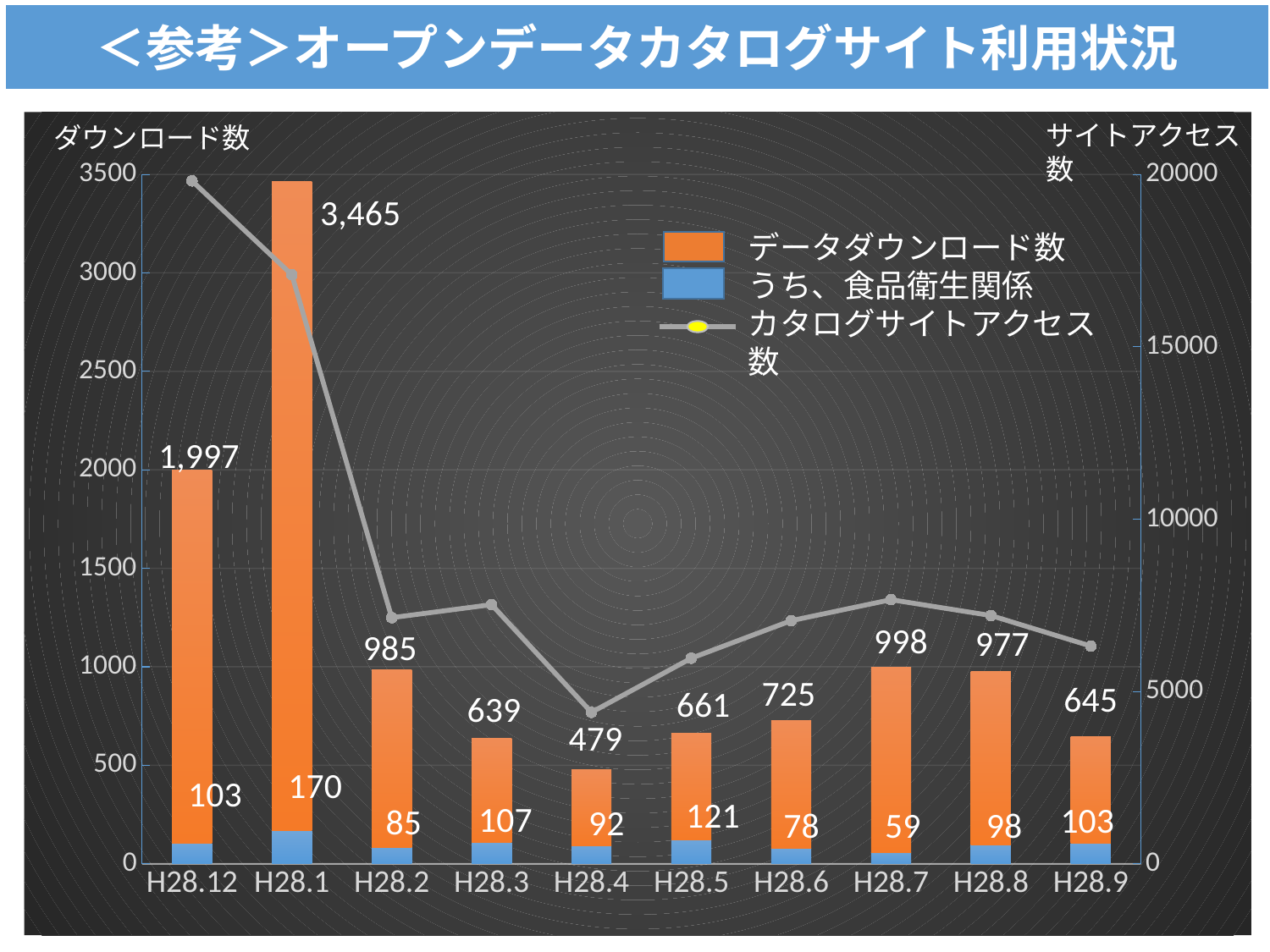
Which month has the lowest food hygiene related count (うち、食品衛生関係)? H28.7 Does the catalog site access count line rise or fall from H28.1 to H28.4? fall Which month has the larger data download count, H28.7 or H28.8? H28.7 Which month has the lowest data download count? H28.4 What is the food hygiene related count (うち、食品衛生関係) for H28.5? 121 How many months are shown on the x axis? 10 Which month has the highest data download count? H28.1 Is the catalog site access count (カタログサイトアクセス数) for H28.4 greater or less than 10000? less How many series does the legend list? 3 What is the difference between the data download counts for H28.1 and H28.12? 1,468 What is the data download count (データダウンロード数) for H28.1? 3,465 Is the catalog site access count (カタログサイトアクセス数) for H28.12 greater or less than 15000? greater